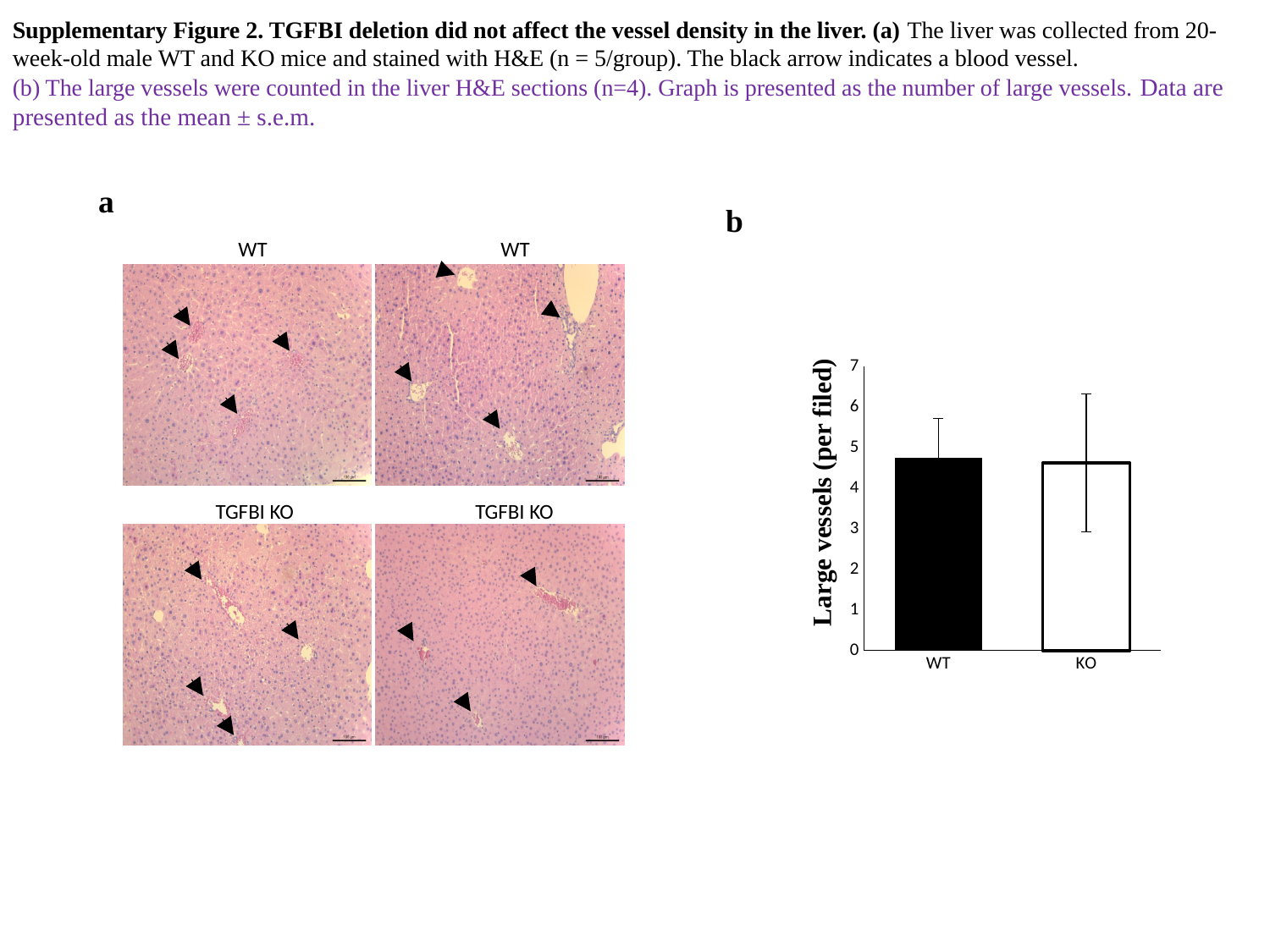
In the bar chart in panel b, is the value for WT greater or less than 4? greater In the bar chart in panel b, what colour is the WT bar? black In the bar chart in panel b, is the value for WT greater or less than 5? less In the bar chart in panel b, is the value for WT greater or less than 6? less What kind of chart is shown in panel b? bar chart How many categories are plotted on the x axis of the bar chart in panel b? 2 What is the highest tick value shown on the y axis of the bar chart in panel b? 7 What is the y-axis label of the bar chart in panel b? Large vessels (per filed)